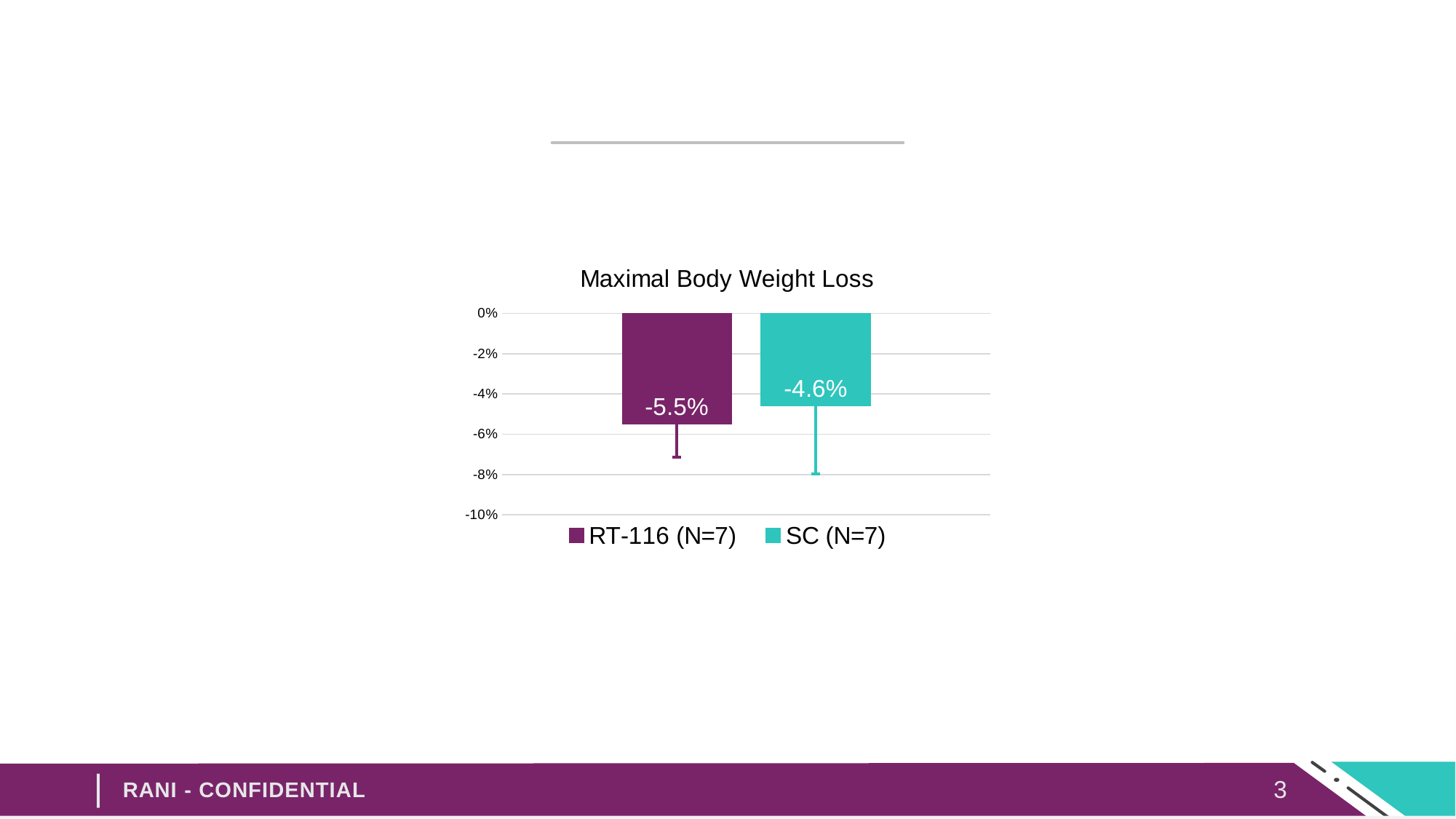
Is the value for SC (N=7) greater or less than -6%? greater How many bars are plotted in the chart? 2 Which series has the highest (least negative) value in the chart? SC (N=7) What is the value for RT-116 (N=7) in the Maximal Body Weight Loss chart? -5.5% What kind of chart is shown on the slide? Bar chart What is the difference between the RT-116 (N=7) and SC (N=7) values? 0.9% How many series does the legend list? 2 What is the value for SC (N=7) in the Maximal Body Weight Loss chart? -4.6% Is the value for RT-116 (N=7) greater or less than -4%? less What is the title of the chart? Maximal Body Weight Loss Which series has the lowest (most negative) value in the chart? RT-116 (N=7) Which series shows the larger body weight loss, RT-116 (N=7) or SC (N=7)? RT-116 (N=7)